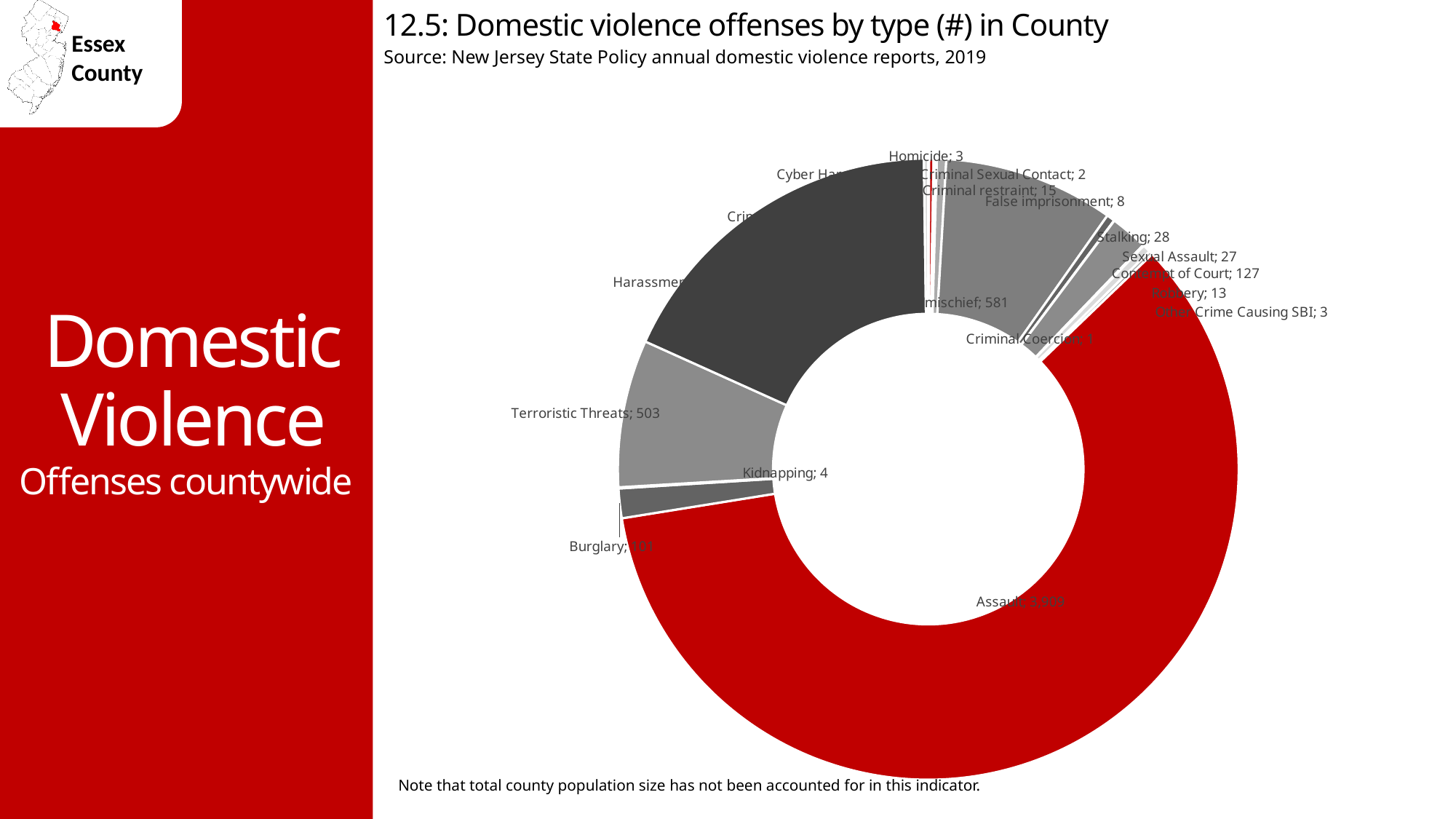
What is the value for Criminal restraint? 15 What is the difference between Terroristic Threats and Contempt of Court? 376 How many Kidnapping offenses are shown? 4 What is the value for Contempt of Court? 127 Which offense type has the largest slice in the chart? Assault Which is larger, Stalking or Sexual Assault? Stalking What is the value for Sexual Assault? 27 What is the title of the chart? 12.5: Domestic violence offenses by type (#) in County What is the value for Homicide? 3 What is the value for Stalking? 28 What kind of chart is shown on the slide? Pie (donut) chart How many Terroristic Threats offenses are shown? 503